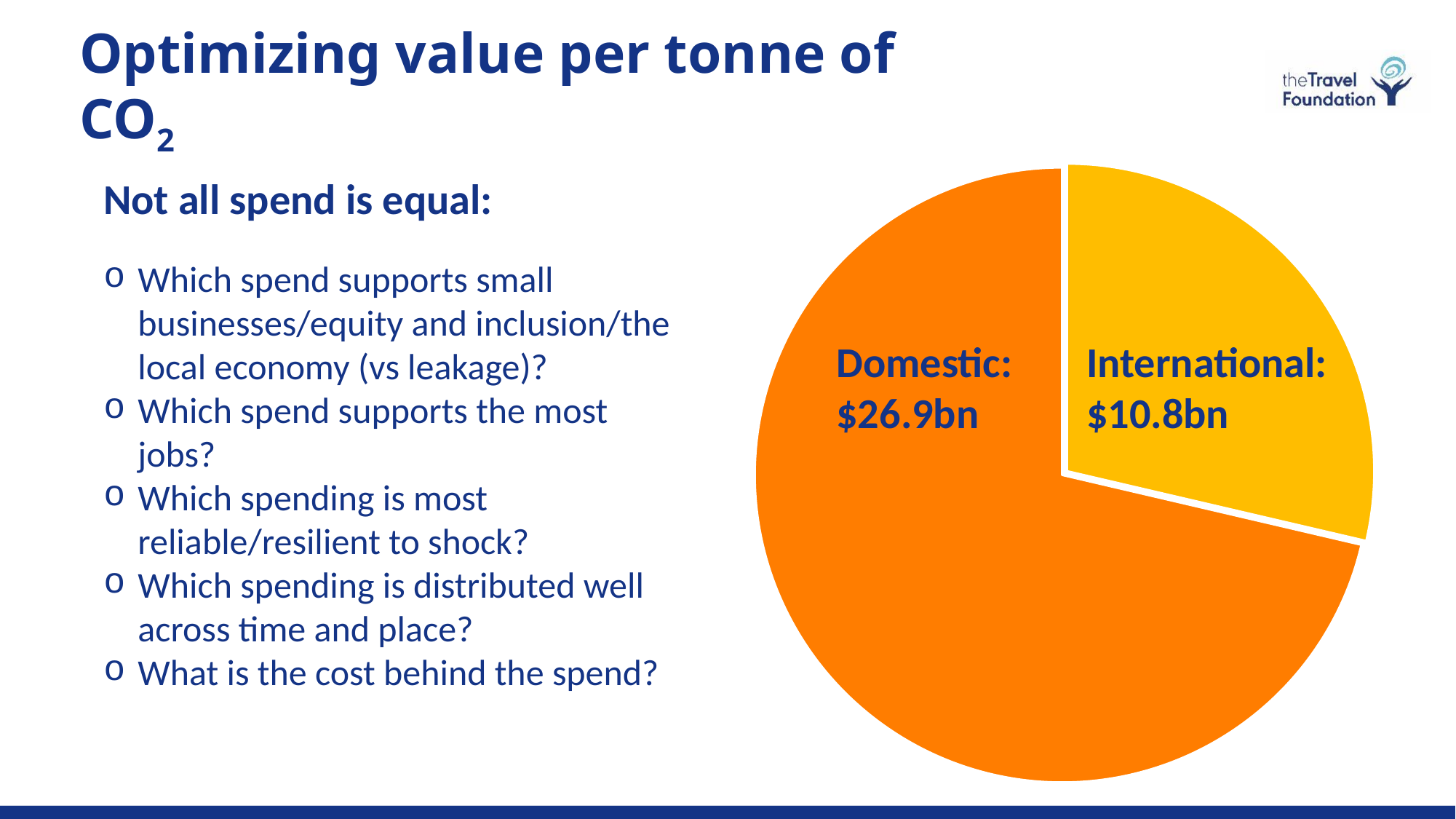
What type of chart is shown on the slide? pie chart How many slices does the pie chart have? 2 What is the difference between the Domestic and International values in the pie chart? $16.1bn Which slice of the pie chart is the smallest? International What share of the pie chart total does the International slice represent? 28.6% Which is larger in the pie chart, Domestic or International? Domestic What is the value of the Domestic slice in the pie chart? $26.9bn What is the value of the International slice in the pie chart? $10.8bn Which slice of the pie chart is the largest? Domestic What colour is the Domestic slice in the pie chart? orange What colour is the International slice in the pie chart? yellow What is the combined total of the two slices in the pie chart? $37.7bn